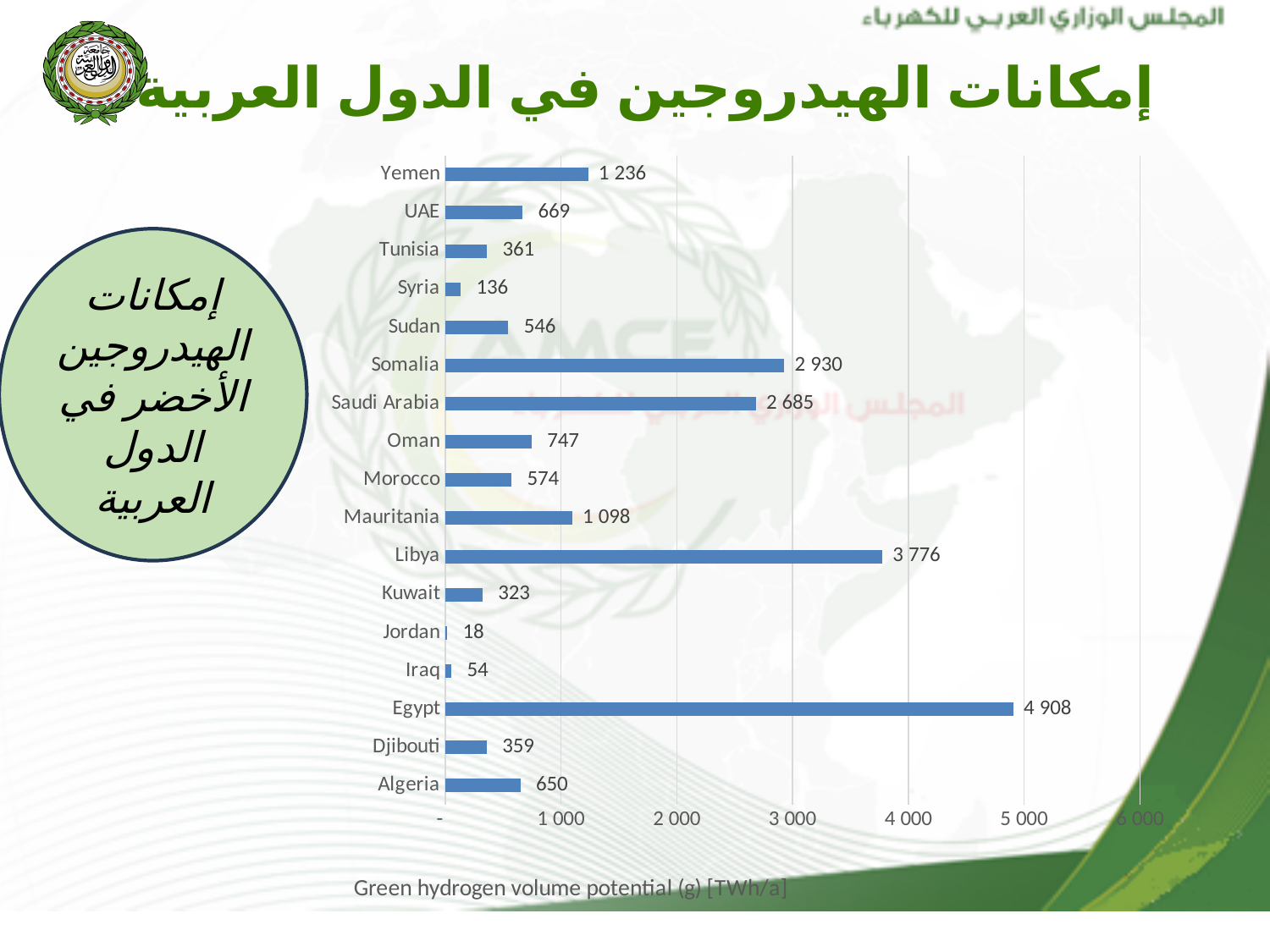
Which has a larger value, Oman or UAE? Oman What value is shown for Somalia? 2 930 Which country has the highest value in the chart? Egypt What is the difference between the values for Somalia and Saudi Arabia? 245 Is the value for Libya greater or less than 3 000? greater What value is shown for Mauritania? 1 098 What is the green hydrogen volume potential value shown for Egypt? 4 908 How many countries are shown in the chart? 17 What value is shown for Jordan? 18 What kind of chart is shown on the slide? bar chart What is the difference between the values for Egypt and Libya? 1 132 Which country has the lowest value in the chart? Jordan